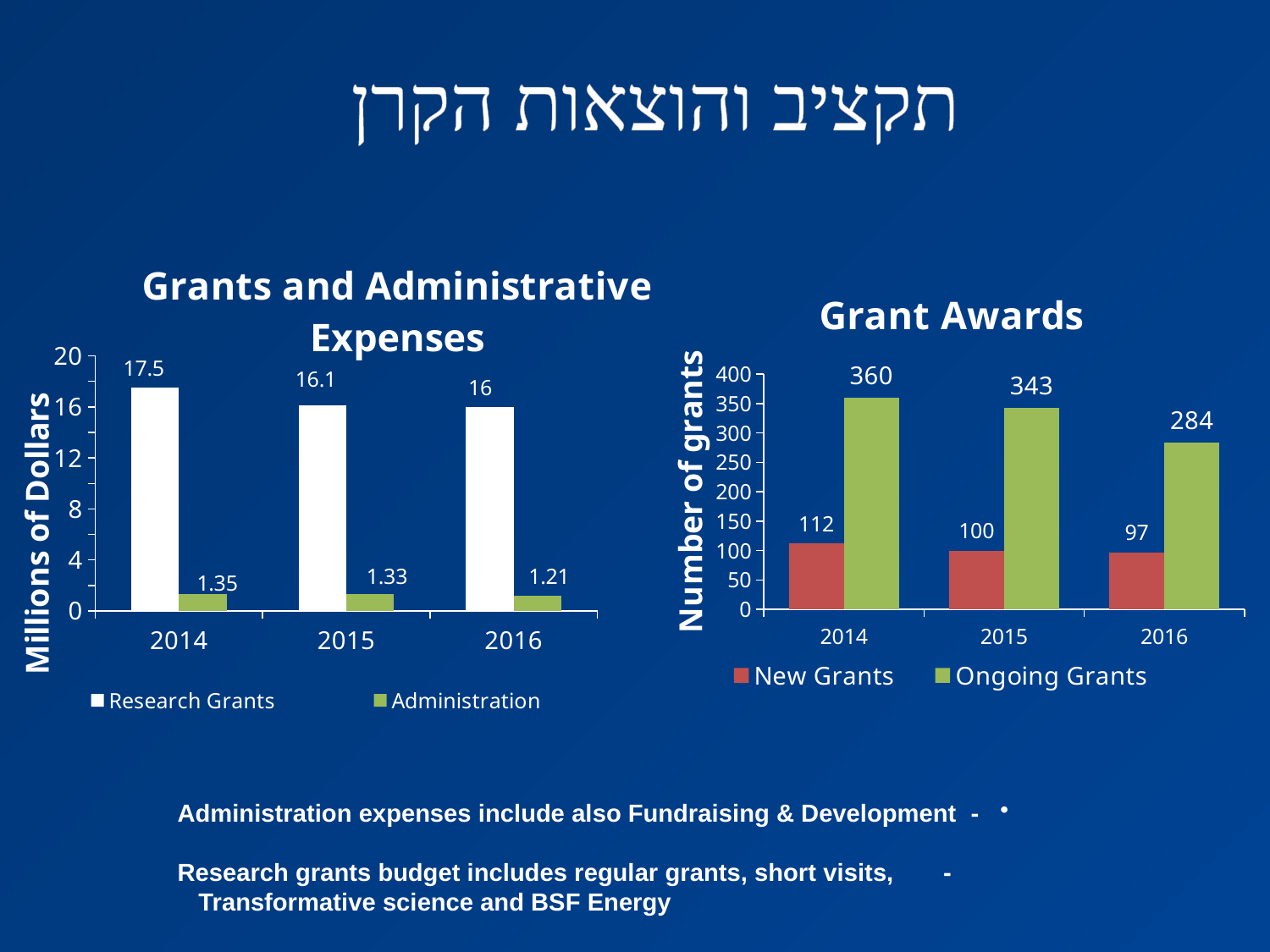
In the 'Grant Awards' chart, which year has the lowest number of Ongoing Grants? 2016 In the 'Grant Awards' chart, which is larger: New Grants in 2014 or New Grants in 2015? New Grants in 2014 In the 'Grant Awards' chart, what is the difference between Ongoing Grants in 2014 and 2016? 76 In the 'Grants and Administrative Expenses' chart, what is the difference between Research Grants in 2014 and 2016? 1.5 In the 'Grants and Administrative Expenses' chart, do the Administration values rise or fall from 2014 to 2016? fall In the 'Grants and Administrative Expenses' chart, what is the value for Research Grants in 2014? 17.5 In the 'Grants and Administrative Expenses' chart, what is the value for Administration in 2016? 1.21 In the 'Grant Awards' chart, what is the number of New Grants in 2016? 97 What kind of chart is the 'Grant Awards' chart? bar chart In the 'Grant Awards' chart, what is the number of Ongoing Grants in 2015? 343 In the 'Grants and Administrative Expenses' chart, how many series does the legend list? 2 In the 'Grants and Administrative Expenses' chart, which year has the highest Research Grants value? 2014